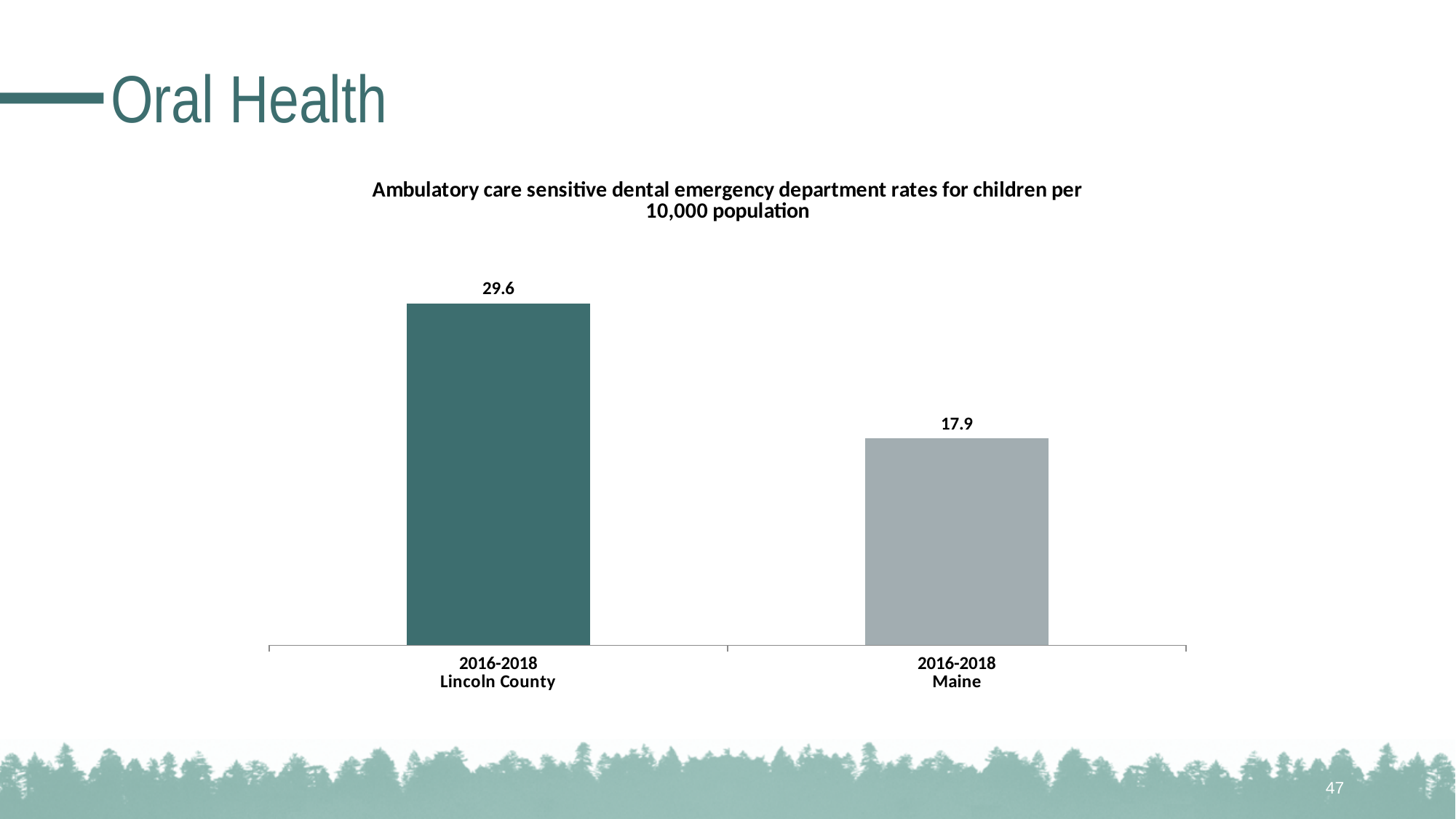
Which category has the higher rate, Lincoln County or Maine? Lincoln County What is the title of the chart? Ambulatory care sensitive dental emergency department rates for children per 10,000 population Is the rate for Maine larger or smaller than the rate for Lincoln County? smaller What is the ambulatory care sensitive dental emergency department rate for children per 10,000 population for Lincoln County in 2016-2018? 29.6 How many bars are shown on the chart? 2 What is the ambulatory care sensitive dental emergency department rate for children per 10,000 population for Maine in 2016-2018? 17.9 Which category has the lowest rate on the chart? Maine What time period do both bars on the chart cover? 2016-2018 What is the difference between the Lincoln County rate and the Maine rate? 11.7 What kind of chart is shown on the slide? bar chart